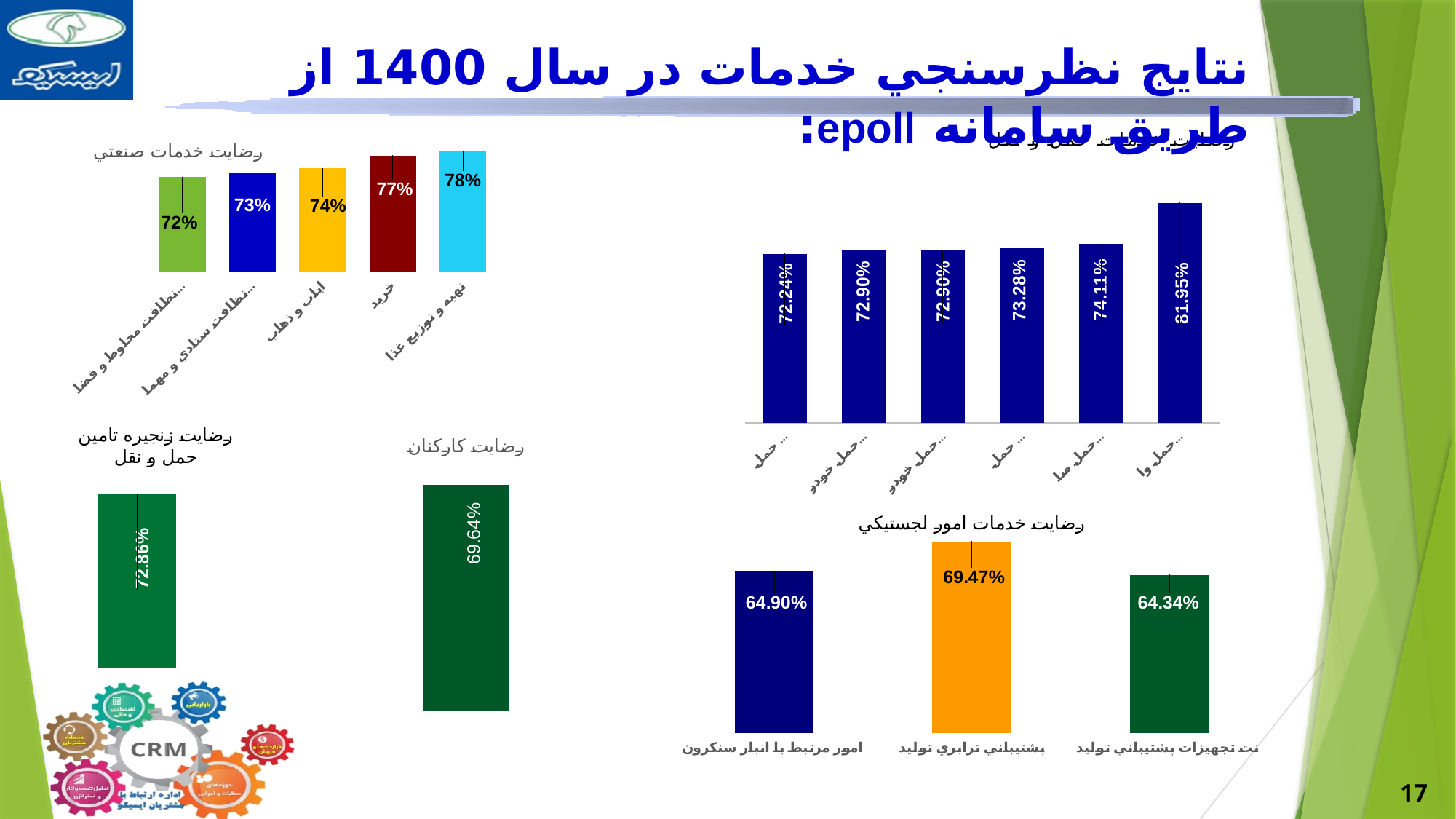
In the chart titled رضایت خدمات صنعتی (top-left), which category has the lowest value? نظافت محوطه و فضا In the chart titled رضایت خدمات امور لجستیکی (bottom-right), what is the value for پشتیبانی ترابری تولید? 69.47% What is the value shown in the chart titled رضایت زنجیره تامین حمل و نقل (bottom-left)? 72.86% In the chart titled رضایت خدمات صنعتی (top-left), what is the value for خرید? 77% What is the value shown in the chart titled رضایت کارکنان (bottom-middle)? 69.64% How many bars are in the top-right chart with dark blue bars? 6 In the chart titled رضایت خدمات صنعتی (top-left), what is the value for تهیه و توزیع غذا? 78% How many bars are in the chart titled رضایت خدمات صنعتی (top-left)? 5 In the top-right chart with six dark blue bars, what is the lowest value shown? 72.24% In the chart titled رضایت خدمات امور لجستیکی (bottom-right), which category has the lowest value? نت تجهیزات پشتیبانی تولید In the top-right chart with six dark blue bars, what is the highest value shown? 81.95% In the chart titled رضایت خدمات صنعتی (top-left), what is the difference between the values for تهیه و توزیع غذا and ایاب و ذهاب? 4%